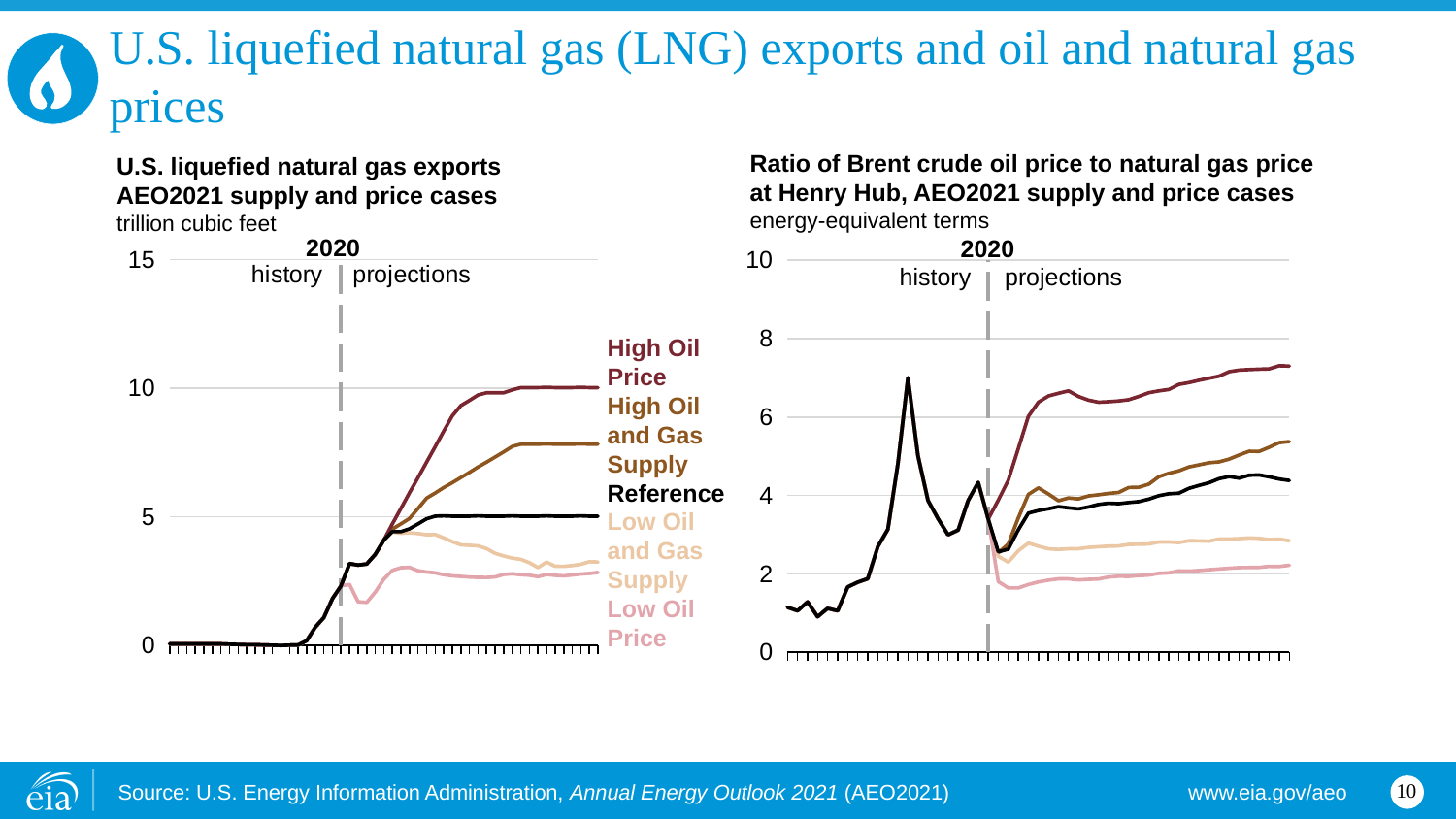
How many series (cases) are shown in the left chart, 'U.S. liquefied natural gas exports'? 5 In the left chart, 'U.S. liquefied natural gas exports', what unit is used on the vertical axis? trillion cubic feet In the left chart, 'U.S. liquefied natural gas exports', which case has the highest exports at the end of the projection period? High Oil Price In the right chart, 'Ratio of Brent crude oil price to natural gas price at Henry Hub', which case has the highest ratio at the end of the projection period? High Oil Price In the left chart, 'U.S. liquefied natural gas exports', which case has the lowest exports at the end of the projection period? Low Oil Price In the right chart, 'Ratio of Brent crude oil price to natural gas price at Henry Hub', is the value for the High Oil Price case at the end of the projections greater or less than 6? greater In the left chart, 'U.S. liquefied natural gas exports', is the value for the High Oil and Gas Supply case at the end of the projections greater or less than 5? greater In the right chart, 'Ratio of Brent crude oil price to natural gas price at Henry Hub', which case has the lowest ratio at the end of the projection period? Low Oil Price What kind of chart is the left chart, 'U.S. liquefied natural gas exports'? line chart In the right chart, 'Ratio of Brent crude oil price to natural gas price at Henry Hub', is the value for the Low Oil and Gas Supply case at the end of the projections greater or less than 4? less In the right chart, 'Ratio of Brent crude oil price to natural gas price at Henry Hub', what year does the dashed vertical line separating history from projections mark? 2020